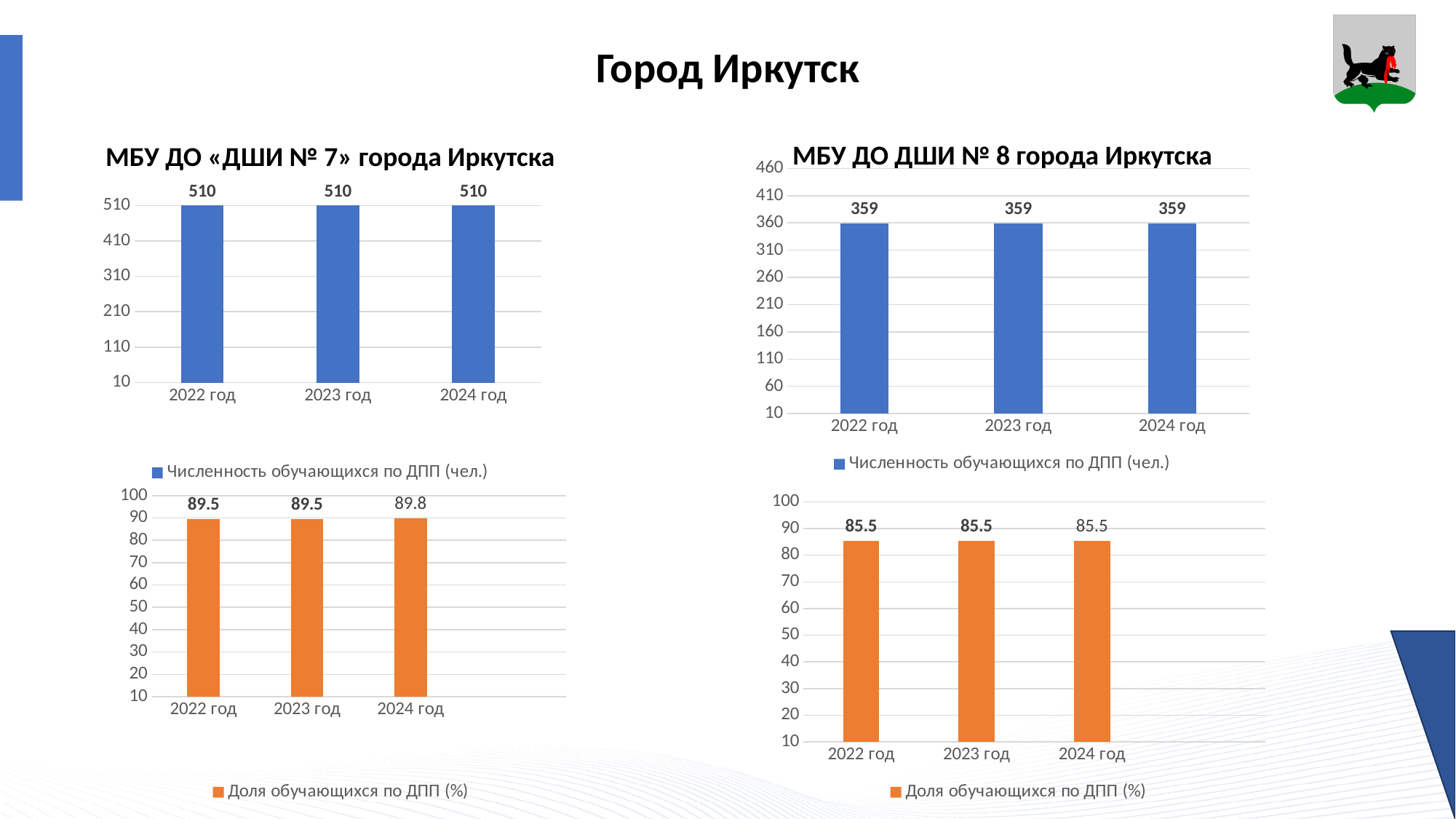
In the bottom-left chart (Доля обучающихся по ДПП (%) for ДШИ № 7), what is the value for 2024 год? 89.8 In the bottom-left chart (Доля обучающихся по ДПП (%) for ДШИ № 7), which year has the highest value? 2024 год Which is larger: the 2023 год value in the top-left chart (ДШИ № 7) or the 2023 год value in the top-right chart (ДШИ № 8)? ДШИ № 7 (510) In the top-left chart titled «МБУ ДО «ДШИ № 7» города Иркутска», what is the value for 2022 год? 510 What is the difference between the 2022 год value in the top-left chart (ДШИ № 7) and the 2022 год value in the top-right chart (ДШИ № 8)? 151 What type of chart is the bottom-right chart (Доля обучающихся по ДПП (%) for ДШИ № 8)? Bar chart How many categories (years) are shown in the top-right chart titled «МБУ ДО ДШИ № 8 города Иркутска»? 3 In the top-left chart titled «МБУ ДО «ДШИ № 7» города Иркутска», do the values rise, fall, or stay the same from 2022 год to 2024 год? Stay the same In the bottom-right chart (Доля обучающихся по ДПП (%) for ДШИ № 8), what is the value for 2023 год? 85.5 In the bottom-left chart (Доля обучающихся по ДПП (%) for ДШИ № 7), what is the difference between the values for 2024 год and 2022 год? 0.3 In the top-right chart titled «МБУ ДО ДШИ № 8 города Иркутска», what is the value for 2024 год? 359 What is the legend entry for the top-right chart titled «МБУ ДО ДШИ № 8 города Иркутска»? Численность обучающихся по ДПП (чел.)